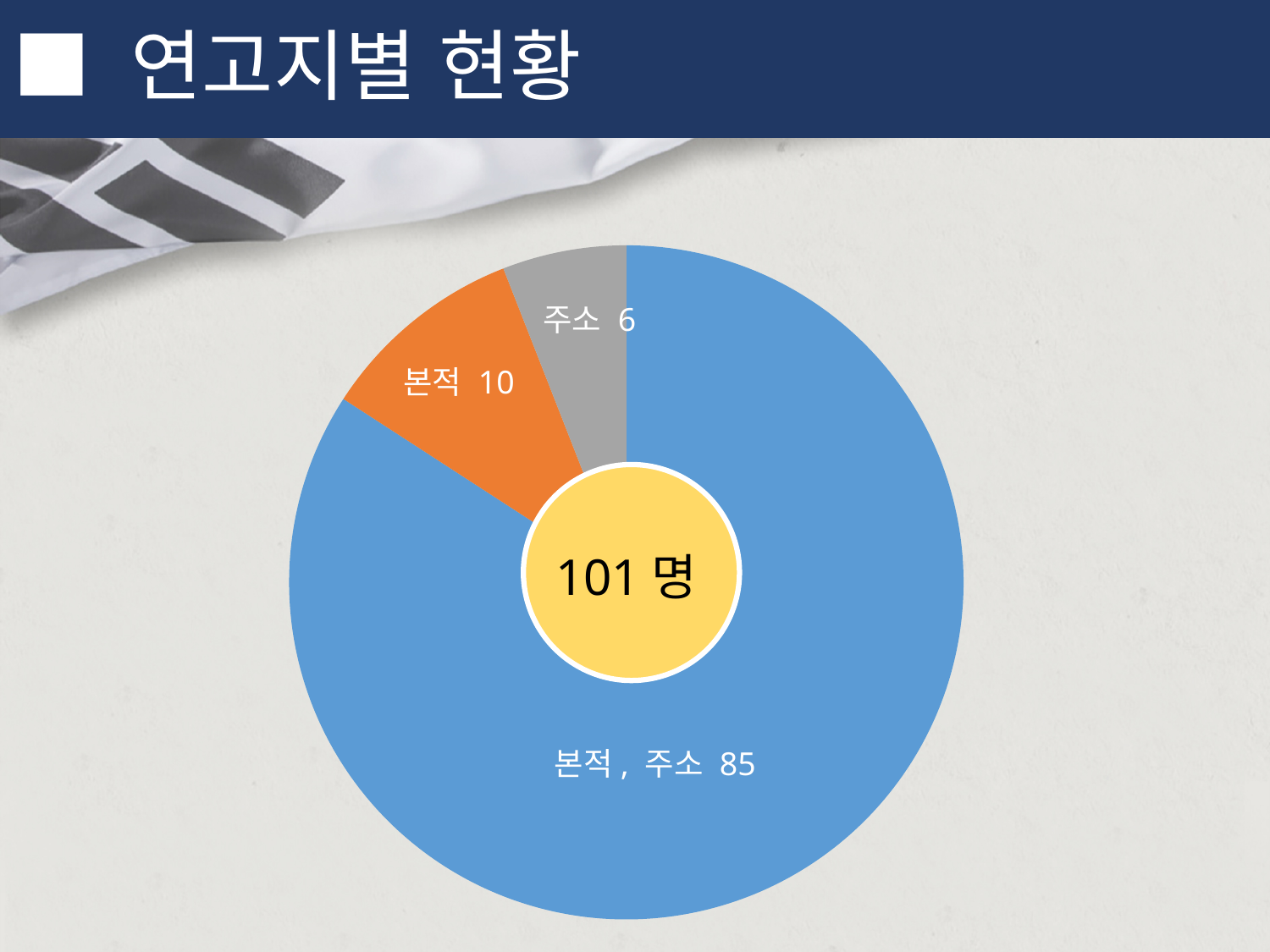
What is the difference between the 본적, 주소 value and the 본적 value? 75 Which is larger, the 본적 slice or the 주소 slice? 본적 What type of chart is shown on the slide? pie chart Which slice of the pie chart is the smallest? 주소 What is the difference between the 본적 value and the 주소 value? 4 What is the value for the 본적, 주소 slice? 85 What is the value for the 본적 slice? 10 Which slice of the pie chart is the largest? 본적, 주소 How many slices does the pie chart have? 3 What is the title of the slide? 연고지별 현황 What total is shown in the centre of the pie chart? 101 명 What is the value for the 주소 slice? 6